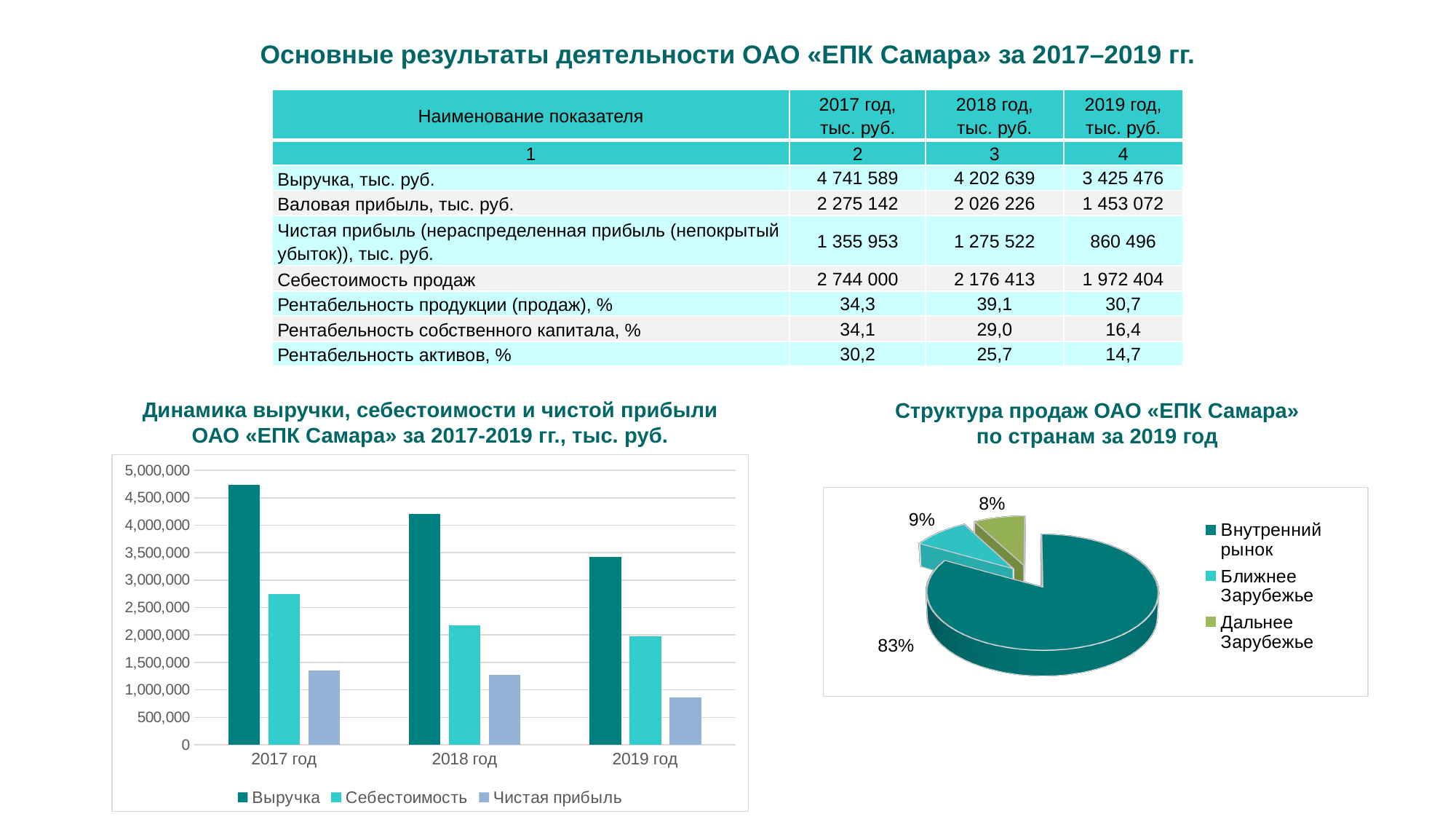
In the bar chart on the left, is the value of Чистая прибыль for 2019 год greater or less than 1,000,000? less In the bar chart on the left, how many series does the legend list? 3 In the bar chart on the left, is the value of Выручка for 2017 год greater or less than 4,500,000? greater What type of chart is the chart titled «Структура продаж ОАО «ЕПК Самара» по странам за 2019 год»? pie chart In the bar chart on the left, how many year categories are shown on the x axis? 3 In the bar chart on the left, is the value of Себестоимость for 2017 год greater or less than 3,000,000? less In the bar chart on the left, does Выручка rise or fall from 2017 год to 2019 год? fall What type of chart is the chart titled «Динамика выручки, себестоимости и чистой прибыли ОАО «ЕПК Самара» за 2017-2019 гг., тыс. руб.»? bar chart In the bar chart on the left, which year has the highest Выручка? 2017 год In the bar chart on the left, which is larger: Себестоимость for 2018 год or Себестоимость for 2019 год? 2018 год In the pie chart on the right, which category has the smallest share? Дальнее Зарубежье In the pie chart on the right, what share of sales does Внутренний рынок have? 83%